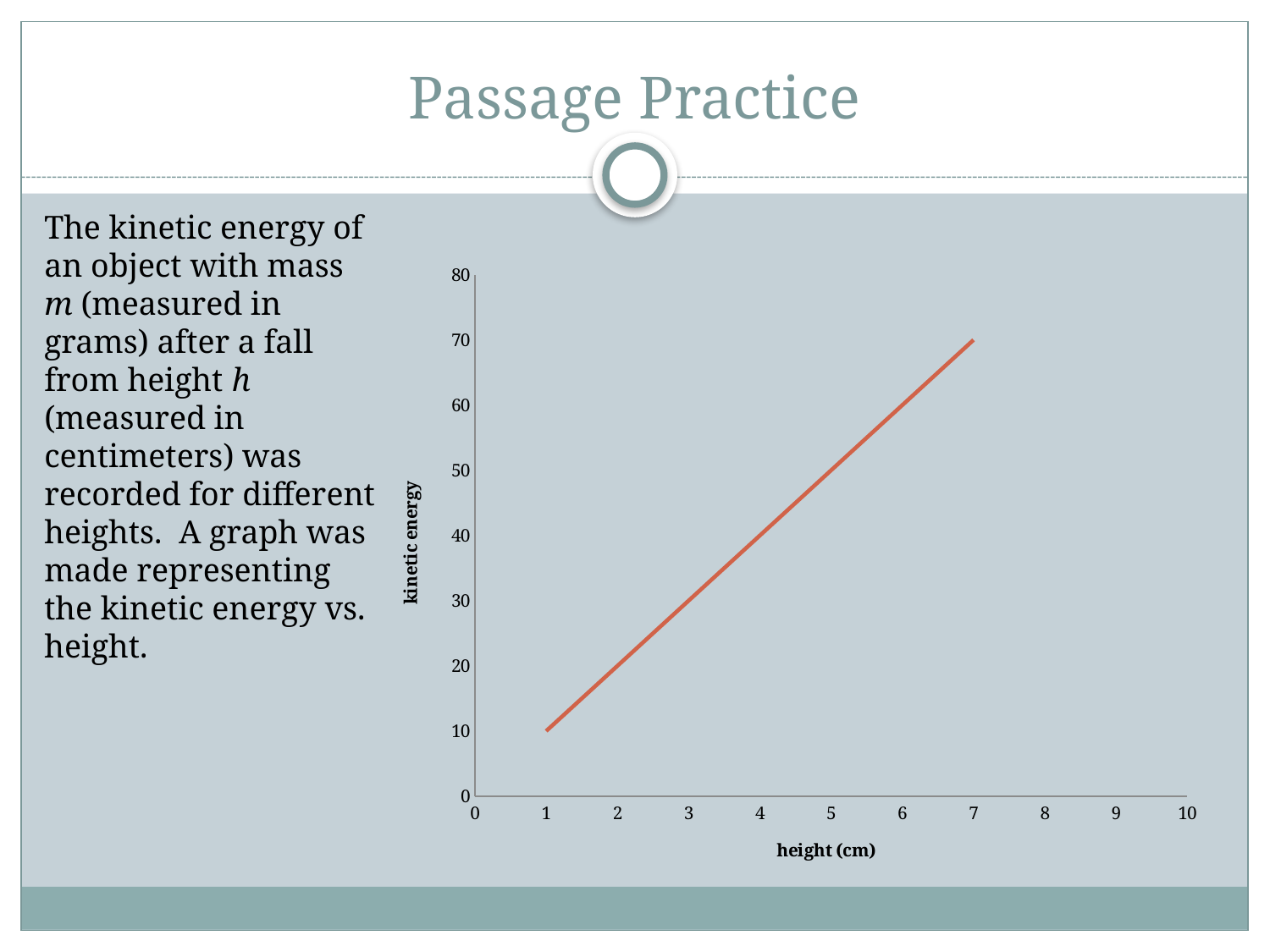
What is the label of the x axis of the chart? height (cm) Is the kinetic energy at a height of 5 cm greater or less than 40? greater What is the kinetic energy at a height of 1 cm? 10 Is the kinetic energy at a height of 4 cm greater or less than 50? less Does the kinetic energy rise or fall as height increases? rises What is the difference between the kinetic energy at 7 cm and at 1 cm? 60 What is the label of the y axis of the chart? kinetic energy What kind of chart is shown on the slide? line chart At which plotted height is the kinetic energy lowest? 1 At which plotted height is the kinetic energy highest? 7 What is the kinetic energy at a height of 7 cm? 70 Is the kinetic energy at a height of 3 cm greater or less than 20? greater